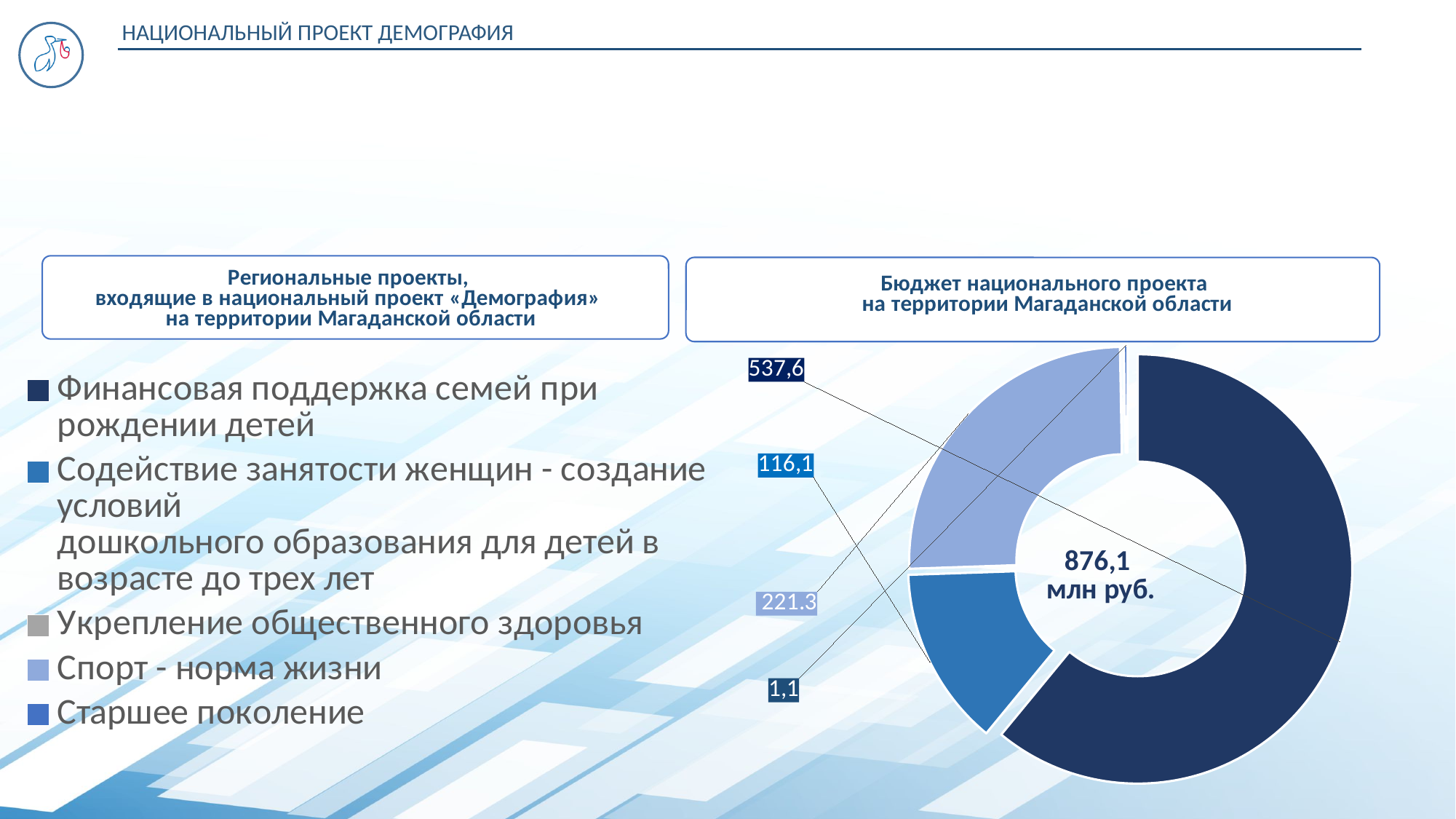
How many categories are listed in the legend on the left of the slide? 5 Which labelled category has the smallest value in the donut chart? Старшее поколение What is the title of the box above the donut chart? Бюджет национального проекта на территории Магаданской области What is the value shown for «Финансовая поддержка семей при рождении детей» in the donut chart? 537,6 What kind of chart is used to show the budget of the national project? Donut (pie) chart What is the value shown for «Содействие занятости женщин» in the donut chart? 116,1 What is the value shown for «Спорт - норма жизни» in the donut chart? 221.3 What total is printed in the centre of the donut chart? 876,1 млн руб. What is the value shown for «Старшее поколение» in the donut chart? 1,1 Which category has the largest slice in the donut chart? Финансовая поддержка семей при рождении детей What is the difference between the values for «Финансовая поддержка семей при рождении детей» and «Спорт - норма жизни»? 316,3 Which is larger: the value for «Спорт - норма жизни» or for «Содействие занятости женщин»? Спорт - норма жизни